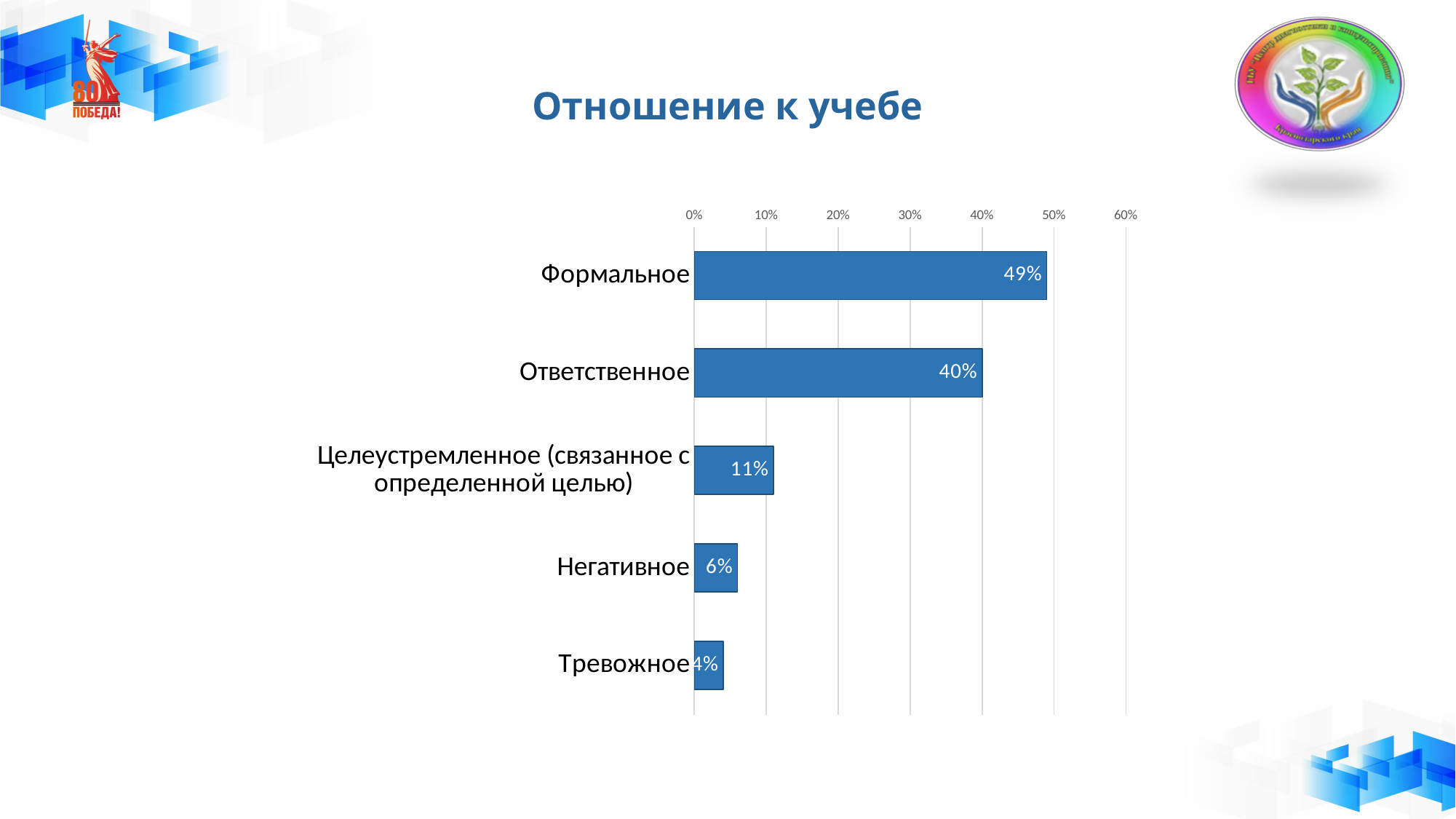
What is the value for Формальное? 49% Which category has the lowest value? Тревожное What is the title of the slide? Отношение к учебе How many categories are shown in the chart? 5 What is the value for Тревожное? 4% Which category has the highest value? Формальное What is the difference between the values for Формальное and Ответственное? 9% What is the value for Негативное? 6% What is the value for Ответственное? 40% What kind of chart is shown on the slide? bar chart What is the value for Целеустремленное (связанное с определенной целью)? 11% Which is larger, the value for Негативное or the value for Тревожное? Негативное